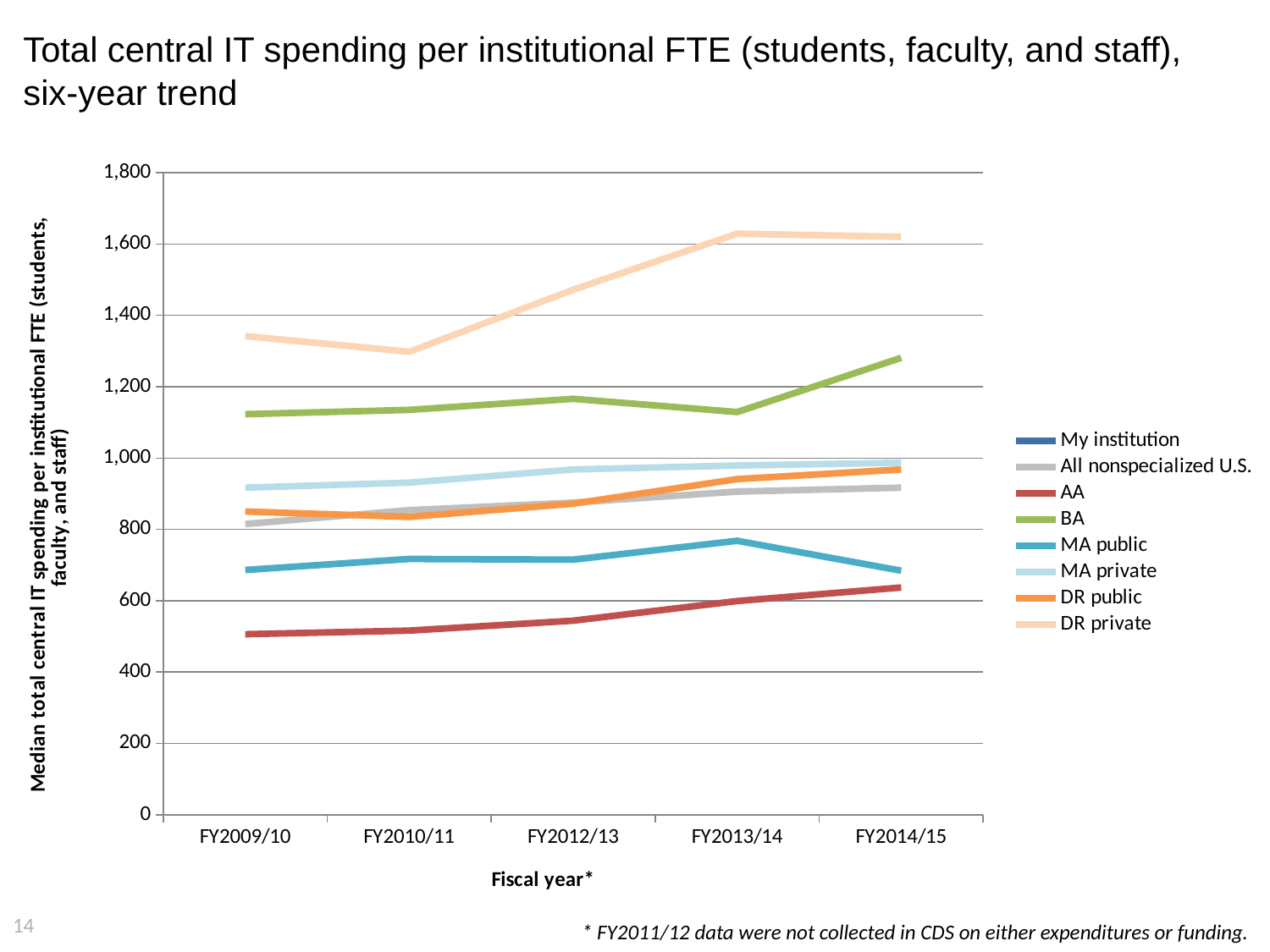
Does the AA series rise or fall from FY2009/10 to FY2014/15? rise How many series does the legend list? 8 What kind of chart is shown on the slide? line chart How many fiscal years are shown on the x axis? 5 Which series has the lowest values across all fiscal years? AA Is the value for MA public in FY2009/10 greater or less than 800? less Is the value for AA in FY2009/10 greater or less than 600? less Which series has the highest values across all fiscal years? DR private Is the value for DR private in FY2009/10 greater or less than 1,200? greater What is the label of the x axis? Fiscal year* Which is higher in FY2014/15, BA or MA private? BA